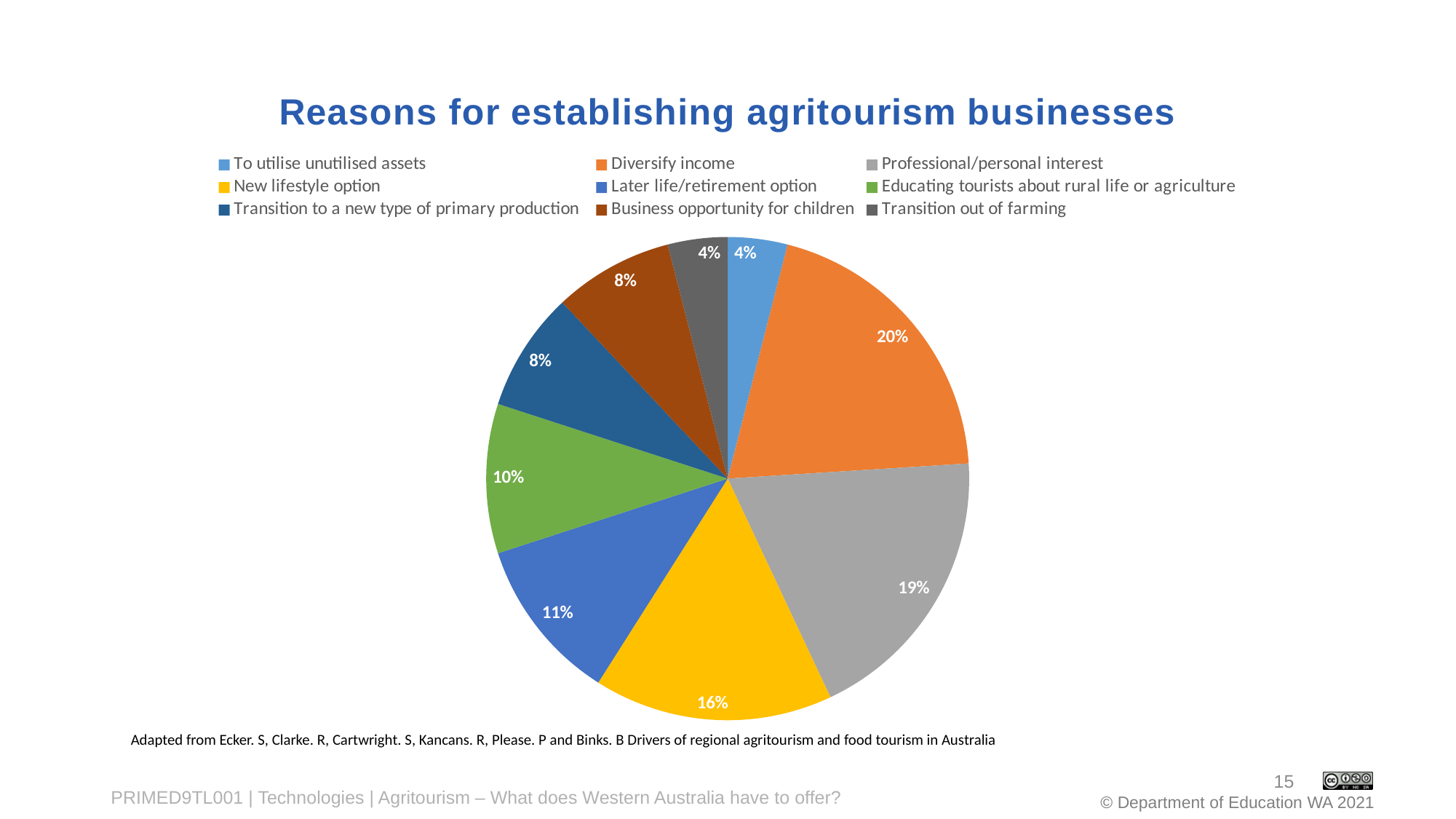
What percentage is shown for Transition out of farming? 4% What share of the pie does New lifestyle option represent? 16% How many slices does the pie chart have? 9 Which is larger, the share for Later life/retirement option or the share for Transition to a new type of primary production? Later life/retirement option What percentage is shown for Educating tourists about rural life or agriculture? 10% What is the difference in percentage points between Diversify income and New lifestyle option? 4 What is the title of the chart? Reasons for establishing agritourism businesses What percentage is shown for Later life/retirement option? 11% What type of chart is shown on the slide? pie chart What percentage of the pie is for Diversify income? 20% Which reason has the largest share of the pie? Diversify income What percentage is shown for Professional/personal interest? 19%